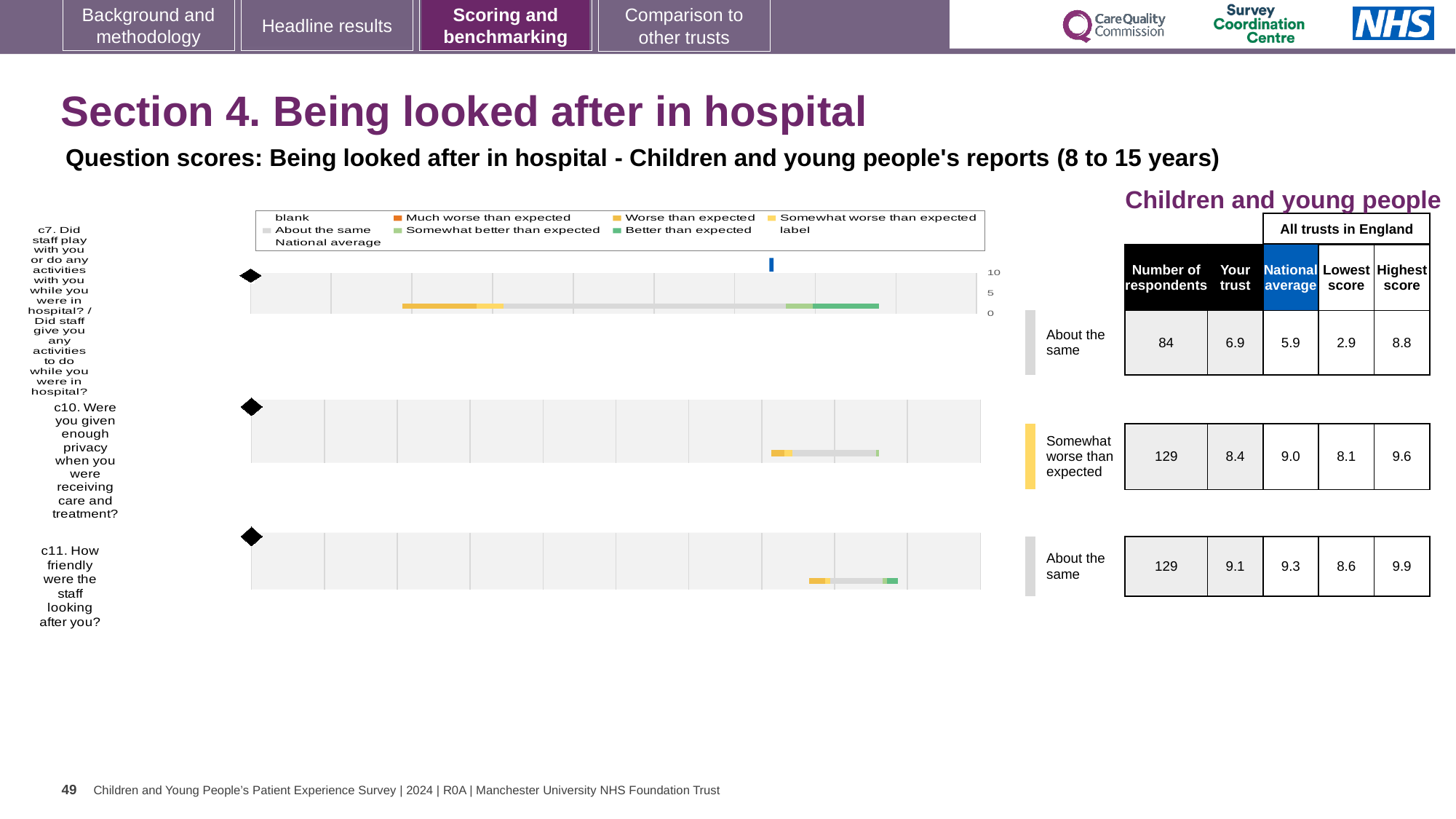
What kind of chart is used to show the question scores on this slide? bar chart What is the difference between the trust score and the national average for c7? 1.0 How many respondents answered c7 (Did staff play with you or do any activities with you while you were in hospital?)? 84 Is the trust score for c10 higher or lower than the national average? lower How many questions (c7, c10, c11) are plotted on the slide? 3 Which of the three questions has the lowest trust score? c7 What benchmark category is c10 assigned to? Somewhat worse than expected What is the trust's score for c11 (How friendly were the staff looking after you?)? 9.1 What is the national average for c10 (Were you given enough privacy when you were receiving care and treatment?)? 9.0 What is the highest score among all trusts in England for c7? 8.8 Which of the three questions has the highest trust score? c11 What is the lowest score among all trusts in England for c11? 8.6